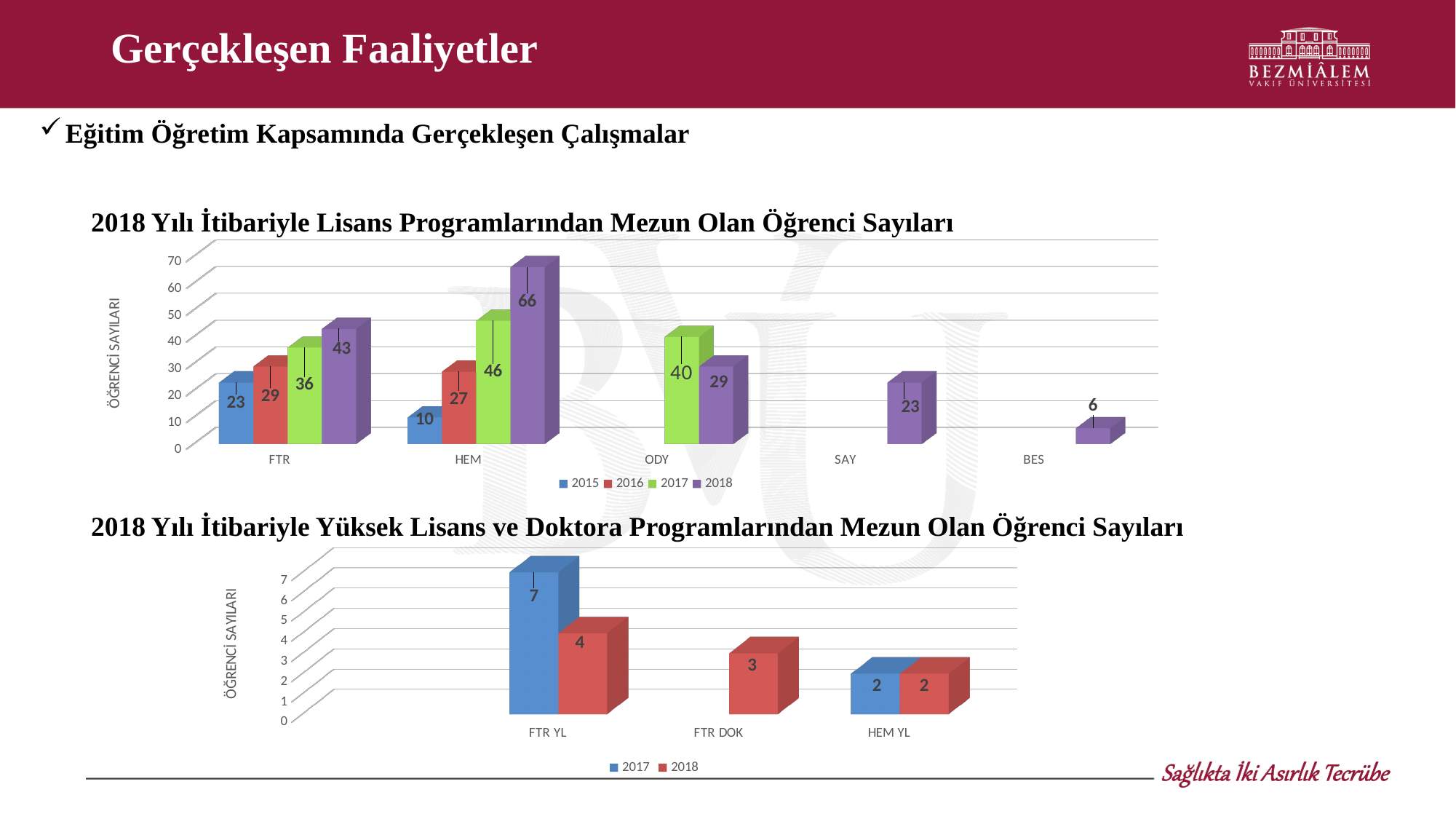
In the bottom chart (Yüksek Lisans ve Doktora Programlarından Mezun Olan Öğrenci Sayıları), what is the value for FTR DOK in 2018? 3 In the top chart (Lisans Programlarından Mezun Olan Öğrenci Sayıları), which category has the highest 2018 value? HEM In the top chart (Lisans Programlarından Mezun Olan Öğrenci Sayıları), what is the difference between the 2017 and 2018 values for ODY? 11 In the bottom chart (Yüksek Lisans ve Doktora Programlarından Mezun Olan Öğrenci Sayıları), which is larger for FTR YL: the 2017 value or the 2018 value? 2017 In the top chart (Lisans Programlarından Mezun Olan Öğrenci Sayıları), do the FTR values rise or fall from 2015 to 2018? rise In the bottom chart (Yüksek Lisans ve Doktora Programlarından Mezun Olan Öğrenci Sayıları), what is the value for FTR YL in 2017? 7 In the top chart (Lisans Programlarından Mezun Olan Öğrenci Sayıları), which category has the lowest 2018 value? BES In the top chart (Lisans Programlarından Mezun Olan Öğrenci Sayıları), how many categories are shown on the x axis? 5 What kind of chart is the bottom chart (Yüksek Lisans ve Doktora Programlarından Mezun Olan Öğrenci Sayıları)? bar chart In the top chart (Lisans Programlarından Mezun Olan Öğrenci Sayıları), what is the value for HEM in 2018? 66 In the top chart (Lisans Programlarından Mezun Olan Öğrenci Sayıları), how many series does the legend list? 4 In the top chart (Lisans Programlarından Mezun Olan Öğrenci Sayıları), what is the value for FTR in 2015? 23